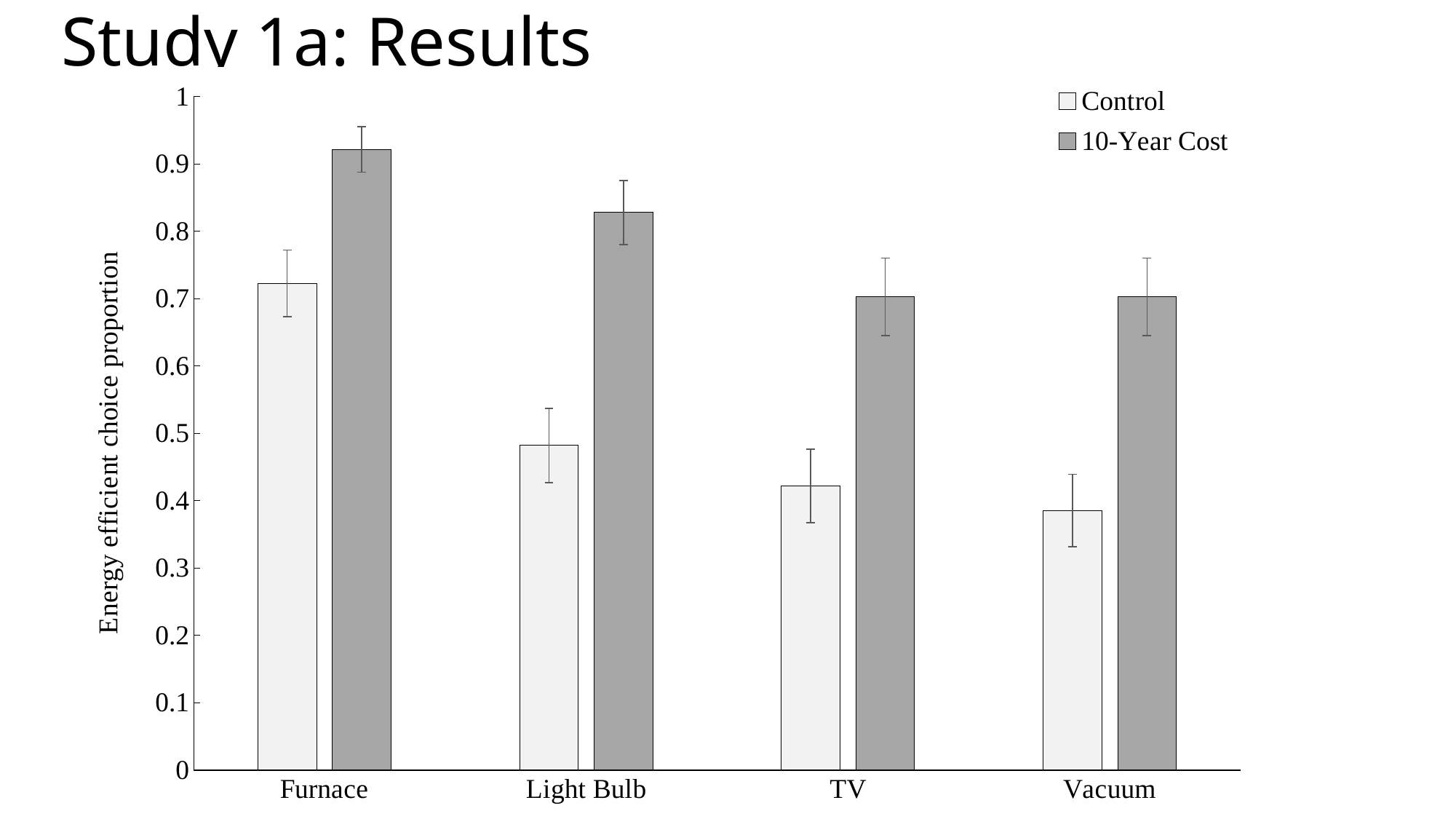
How many series does the legend list? 2 Which category has the highest 10-Year Cost bar? Furnace Is the 10-Year Cost value for Furnace greater or less than 0.9? greater For Light Bulb, which is larger: the Control bar or the 10-Year Cost bar? 10-Year Cost Is the Control value for Furnace greater or less than 0.6? greater Is the 10-Year Cost value for Light Bulb greater or less than 0.8? greater What kind of chart is shown on the slide? bar chart What is the label on the y axis? Energy efficient choice proportion Which is larger: the Control value for Furnace or the Control value for Light Bulb? Furnace Which category has the lowest Control bar? Vacuum How many product categories are shown on the x axis? 4